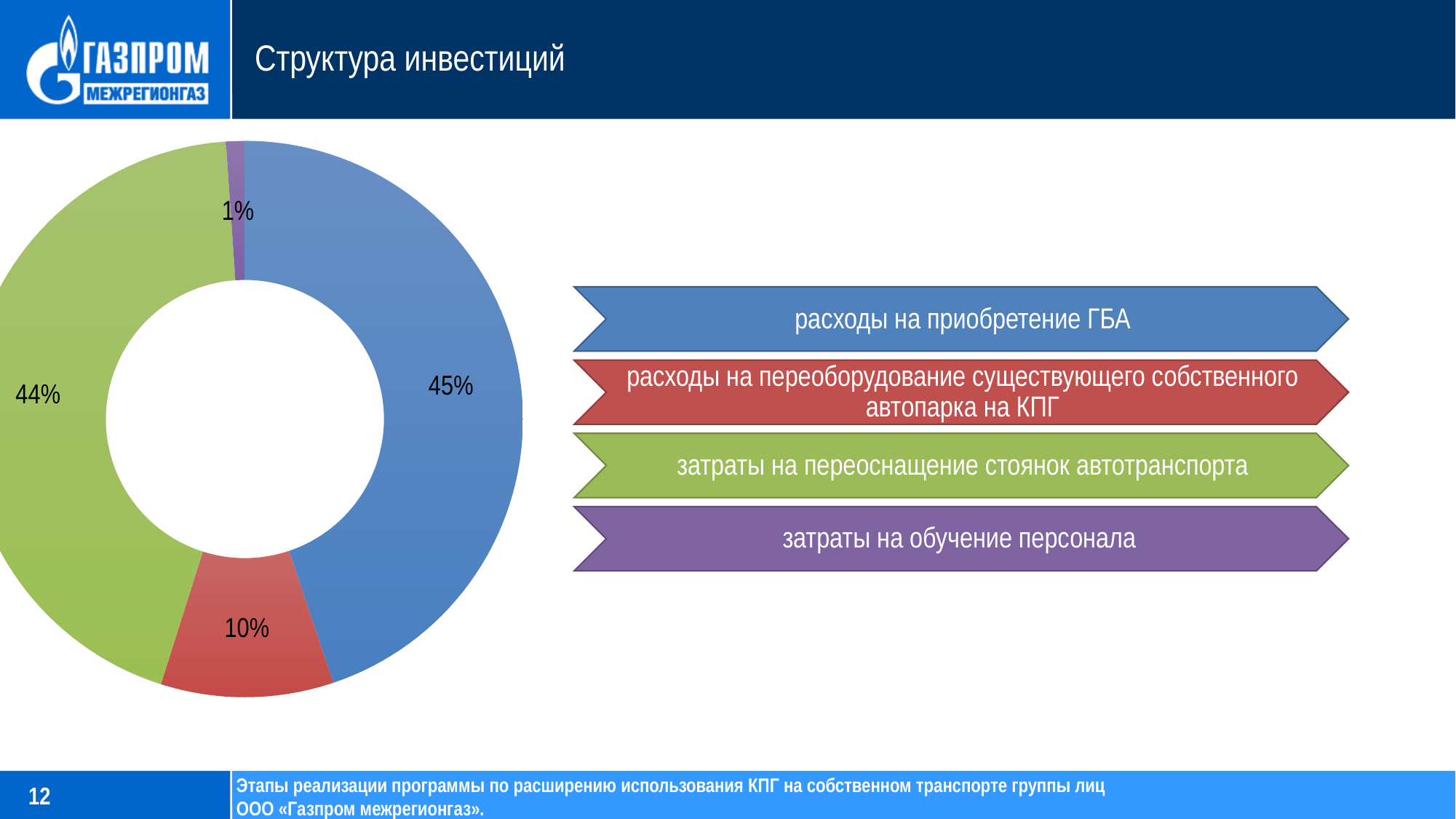
What share of investments goes to затраты на обучение персонала? 1% Which is larger: the share for затраты на переоснащение стоянок автотранспорта or the share for расходы на переоборудование существующего собственного автопарка на КПГ? затраты на переоснащение стоянок автотранспорта How many categories are shown in the chart? 4 What colour represents затраты на обучение персонала in the chart? Purple What share of investments goes to расходы на приобретение ГБА? 45% Which category has the smallest share of investments? затраты на обучение персонала What is the title of the slide containing the chart? Структура инвестиций What share of investments goes to затраты на переоснащение стоянок автотранспорта? 44% Which category has the largest share of investments? расходы на приобретение ГБА What share of investments goes to расходы на переоборудование существующего собственного автопарка на КПГ? 10% What is the difference in percentage points between расходы на приобретение ГБА and расходы на переоборудование существующего собственного автопарка на КПГ? 35 What kind of chart is shown on the slide? Pie (donut) chart